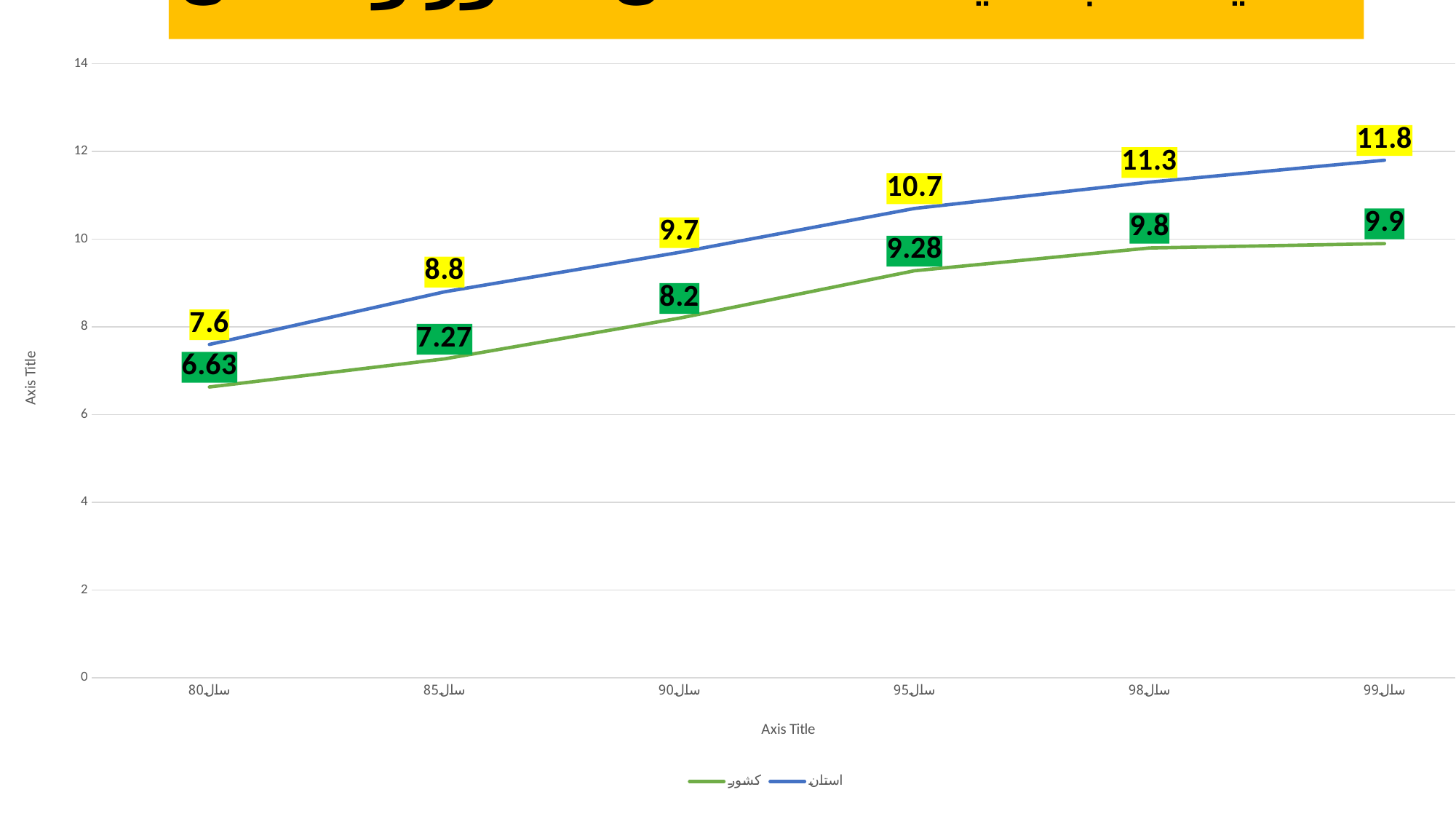
What type of chart is shown on the slide? line chart For which category is the کشور series lowest? سال80 How many series does the legend list? 2 What is the difference between the استان and کشور values for سال90? 1.5 What is the value of the کشور series for سال85? 7.27 What is the value of the استان series for سال80? 7.6 For which category is the استان series highest? سال99 Which series has the larger value for سال98, استان or کشور? استان What is the value of the استان series for سال95? 10.7 Does the استان series rise or fall from سال80 to سال99? rise What is the value of the کشور series for سال99? 9.9 How many categories are shown on the x axis? 6